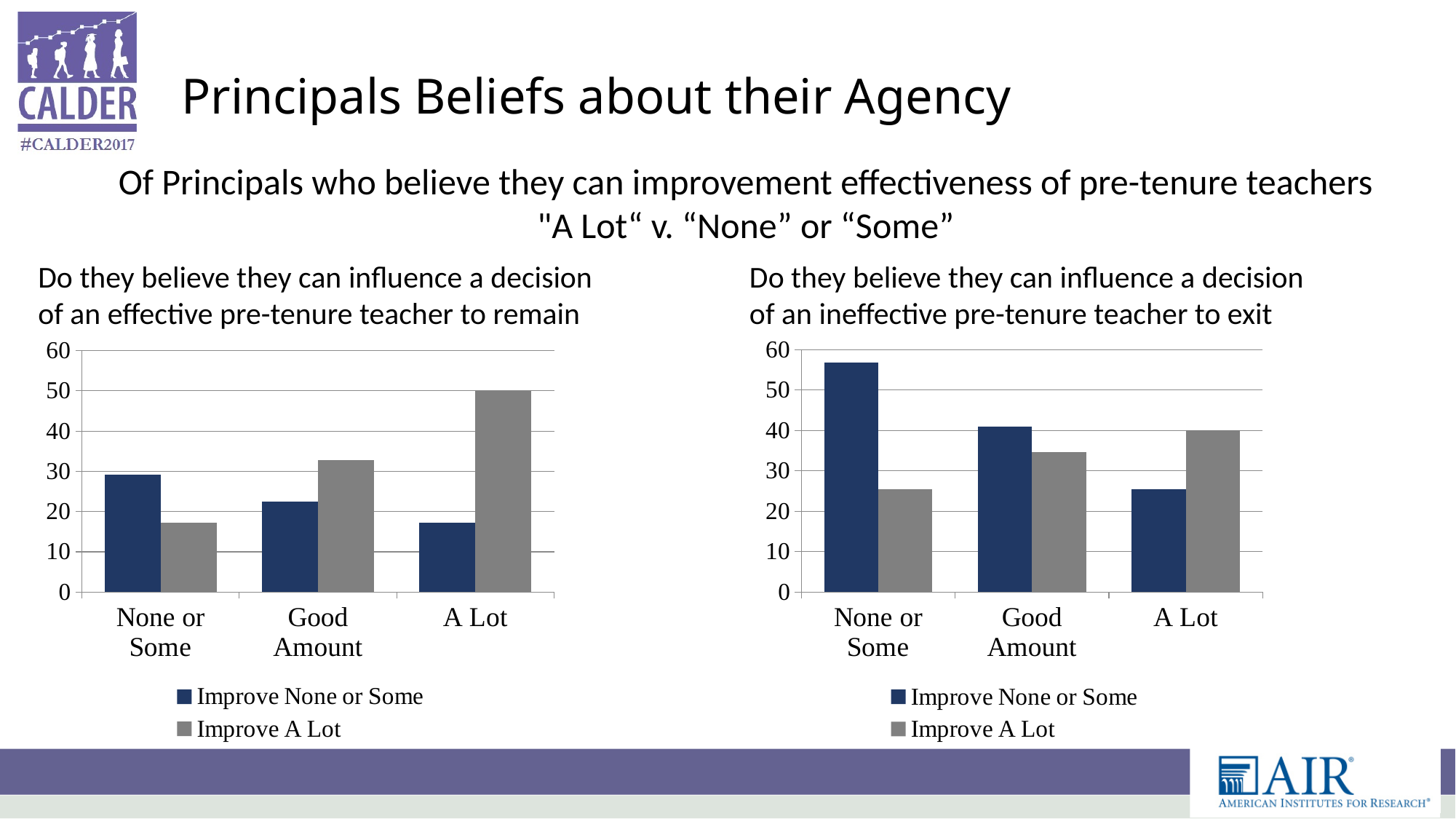
What colour are the 'Improve A Lot' bars in both charts? gray In the right chart (ineffective pre-tenure teacher to exit), is the 'Improve None or Some' value for 'None or Some' greater or less than 50? greater In the right chart (ineffective pre-tenure teacher to exit), which is larger for 'A Lot': 'Improve None or Some' or 'Improve A Lot'? Improve A Lot What type of chart is the left chart (effective pre-tenure teacher to remain)? bar chart In the left chart (effective pre-tenure teacher to remain), which category has the lowest 'Improve None or Some' bar? A Lot In the right chart (ineffective pre-tenure teacher to exit), which category has the highest 'Improve None or Some' bar? None or Some In the left chart (effective pre-tenure teacher to remain), which category has the highest 'Improve A Lot' bar? A Lot In the right chart (ineffective pre-tenure teacher to exit), which category has the lowest 'Improve A Lot' bar? None or Some How many categories are shown on the x axis of the left chart (effective pre-tenure teacher to remain)? 3 How many series does the legend of the right chart (ineffective pre-tenure teacher to exit) list? 2 In the left chart (effective pre-tenure teacher to remain), is the 'Improve A Lot' value for 'None or Some' greater or less than 20? less In the left chart (effective pre-tenure teacher to remain), is the 'Improve None or Some' value for 'None or Some' greater or less than 20? greater